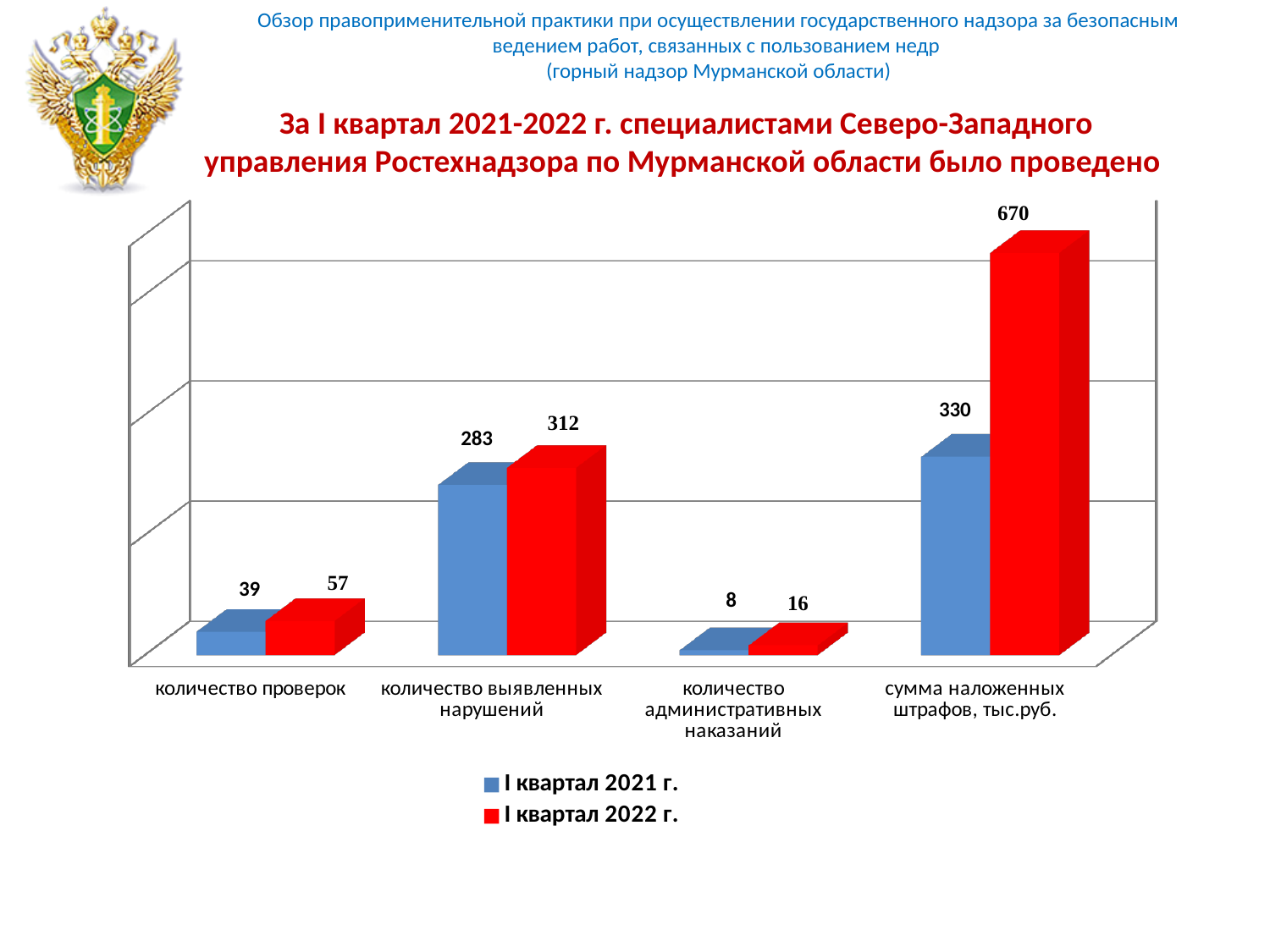
Which series has the larger value for 'количество выявленных нарушений': 'I квартал 2021 г.' or 'I квартал 2022 г.'? I квартал 2022 г. What kind of chart is shown on the slide? bar chart What is the difference between the 'I квартал 2022 г.' and 'I квартал 2021 г.' values for 'сумма наложенных штрафов, тыс.руб.'? 340 What is the value for 'количество проверок' in the 'I квартал 2021 г.' series? 39 What is the difference between the 'I квартал 2022 г.' and 'I квартал 2021 г.' values for 'количество проверок'? 18 Which category has the highest value in the 'I квартал 2022 г.' series? сумма наложенных штрафов, тыс.руб. What is the value for 'количество административных наказаний' in the 'I квартал 2021 г.' series? 8 Which category has the lowest value in the 'I квартал 2021 г.' series? количество административных наказаний How many series does the legend list? 2 What is the value for 'количество выявленных нарушений' in the 'I квартал 2022 г.' series? 312 What is the value for 'сумма наложенных штрафов, тыс.руб.' in the 'I квартал 2022 г.' series? 670 How many categories are shown on the x axis of the chart? 4